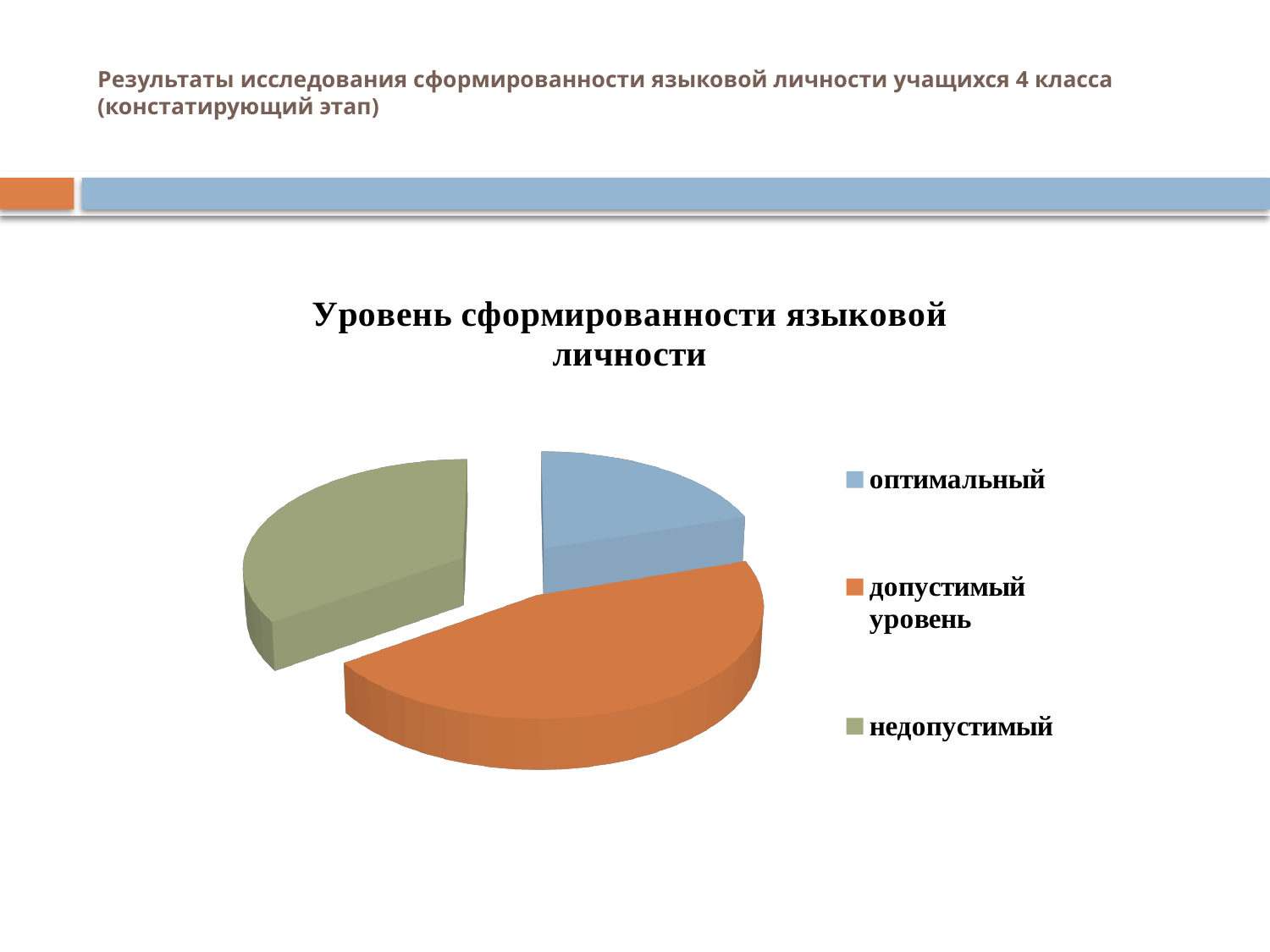
What colour is the slice for недопустимый? green How many slices does the pie chart have? 3 Which slice is larger, оптимальный or допустимый уровень? допустимый уровень What kind of chart is shown on the slide? pie chart Which category has the smallest slice of the pie? оптимальный How many entries does the legend list? 3 What is the title of the chart? Уровень сформированности языковой личности Which slice is larger, допустимый уровень or недопустимый? допустимый уровень Which slice is larger, оптимальный or недопустимый? недопустимый Which category has the largest slice of the pie? допустимый уровень